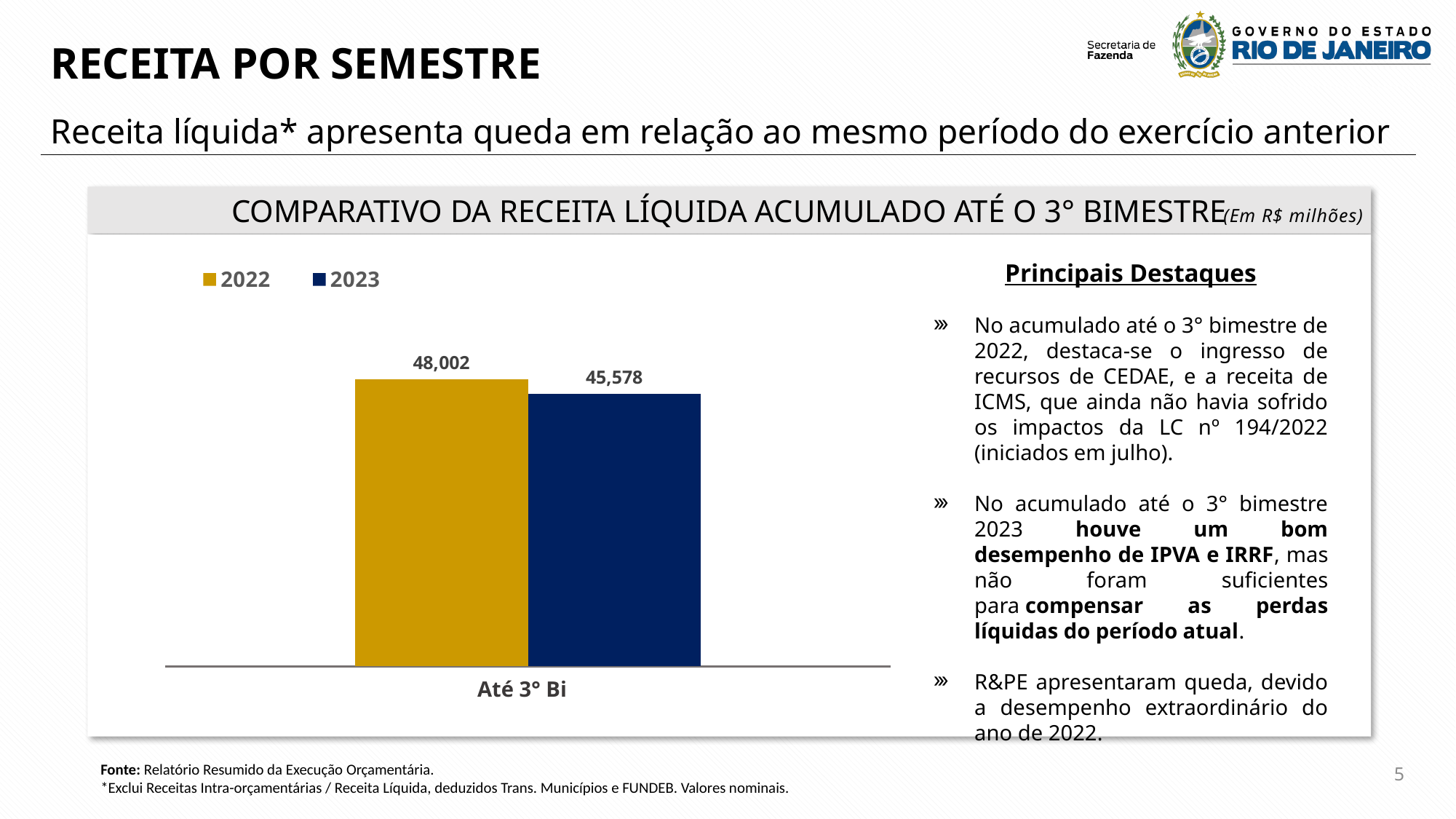
What is the value for 2022 in the chart? 48,002 What is the difference between the 2022 value and the 2023 value? 2,424 Which series shows the highest value in the chart? 2022 What kind of chart is shown on the slide? Bar chart How many categories are shown on the x axis of the chart? 1 Which series has the higher value, 2022 or 2023? 2022 Which series shows the lowest value in the chart? 2023 What is the label of the category on the x axis? Até 3° Bi Did the value fall or rise from 2022 to 2023? Fall What is the value for 2023 in the chart? 45,578 What unit is stated for the values in the chart title? Em R$ milhões How many series does the chart legend list? 2